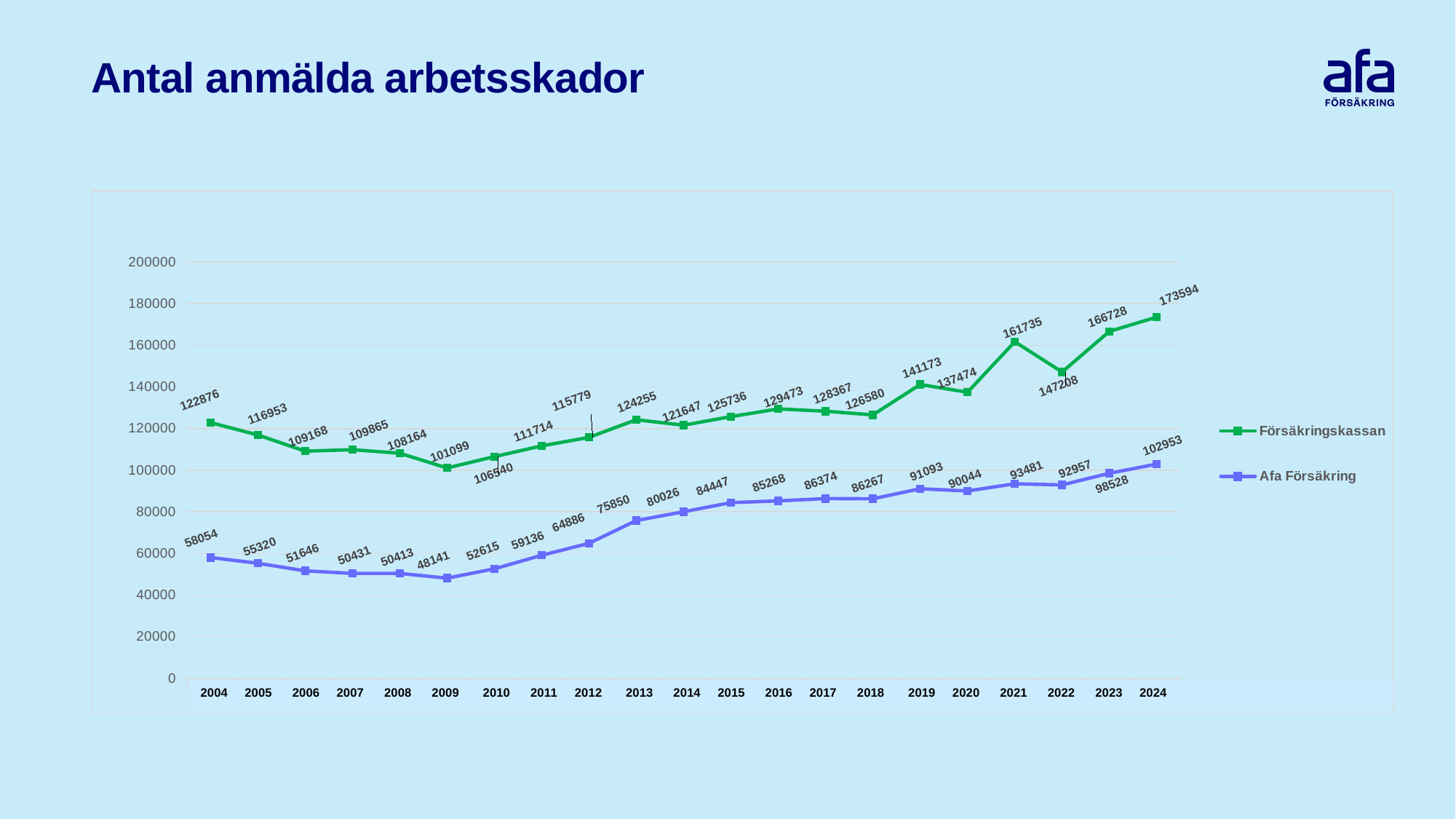
How many years are shown on the x axis? 21 In which year is the Försäkringskassan series at its lowest? 2009 In which year is the Afa Försäkring series at its highest? 2024 By how much did the Försäkringskassan value change from 2023 to 2024? 6866 What is the value for Afa Försäkring in 2009? 48141 How many series does the legend list? 2 What kind of chart is shown on the slide? Line chart What is the value for Försäkringskassan in 2021? 161735 What is the difference between the Försäkringskassan and Afa Försäkring values in 2024? 70641 Which is larger, the Försäkringskassan value in 2021 or in 2022? 2021 What is the value for Försäkringskassan in 2024? 173594 Does the Afa Försäkring series generally rise or fall from 2009 to 2024? Rise